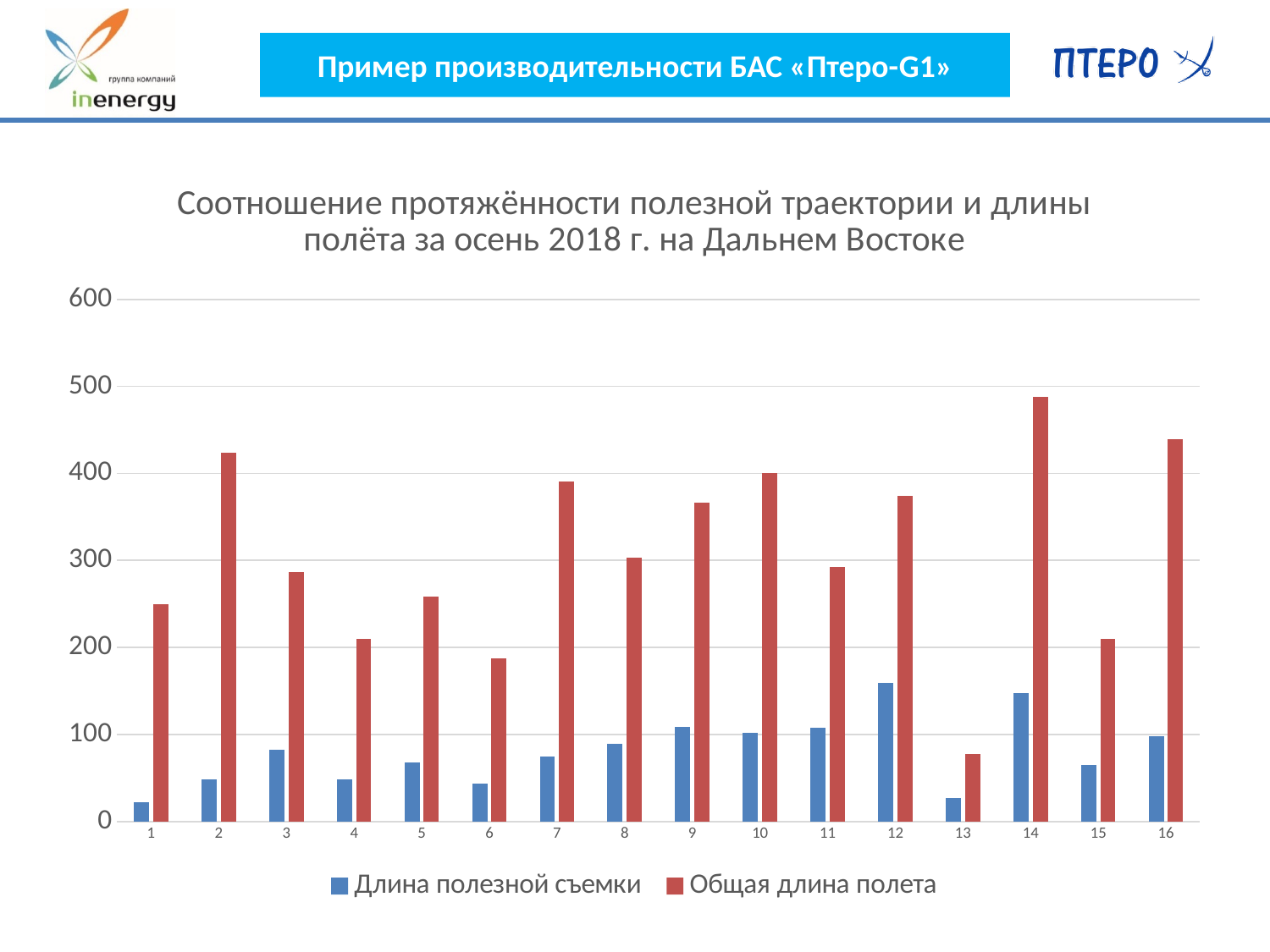
Is the value of Общая длина полета for category 6 greater or less than 200? less How many series does the legend list? 2 Is the value of Длина полезной съемки for category 12 greater or less than 100? greater Is the value of Общая длина полета for category 14 greater or less than 400? greater What colour are the bars for Общая длина полета? Red What kind of chart is shown on the slide? Bar chart How many categories are shown along the x axis? 16 Which category has the lowest value for Общая длина полета? 13 Which category has the highest value for Общая длина полета? 14 Which category has the highest value for Длина полезной съемки? 12 Which is larger: Общая длина полета for category 10 or for category 8? Category 10